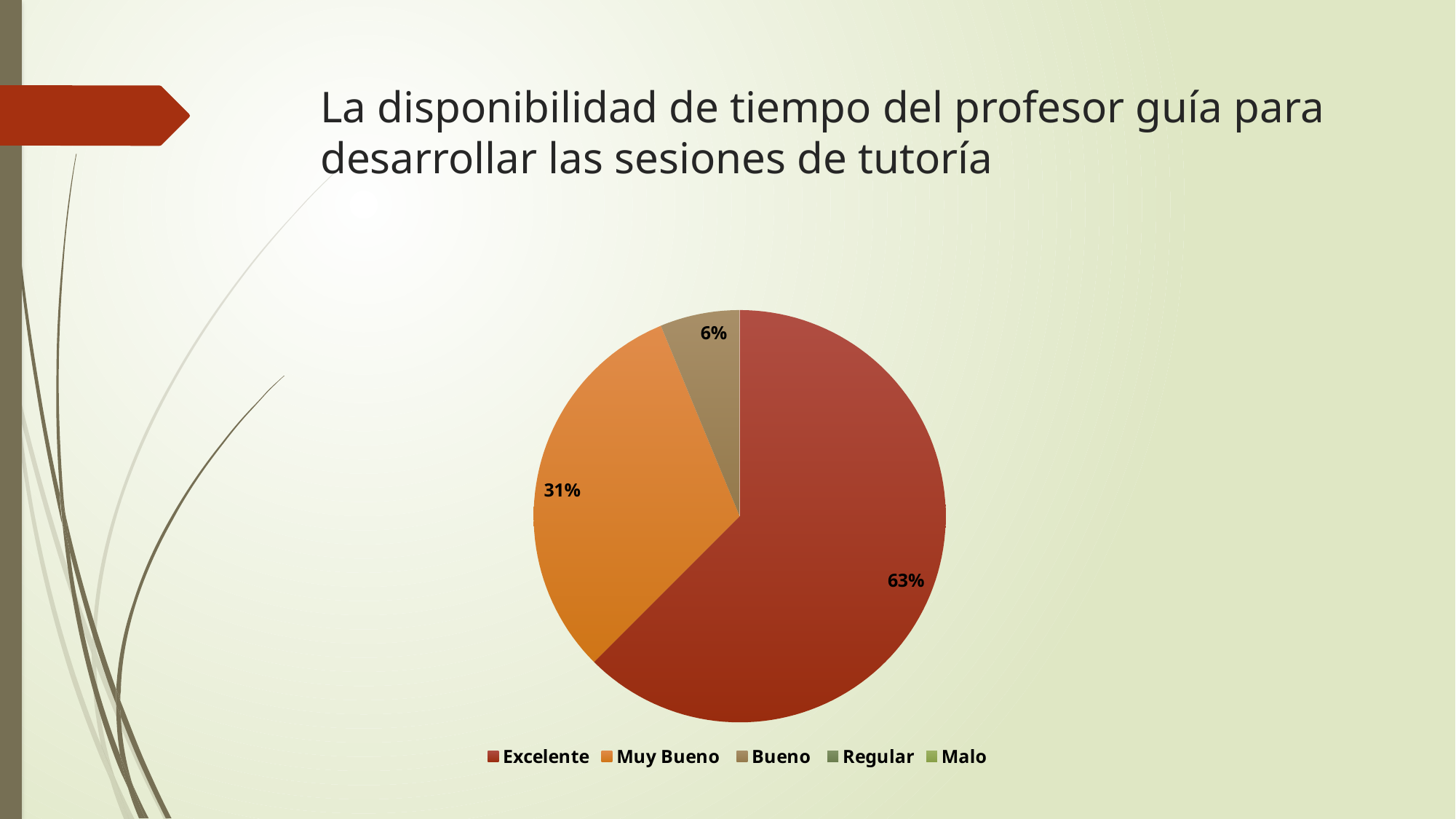
What is the difference between the Muy Bueno and Bueno shares? 25% What share of the pie does Bueno have? 6% Which is larger, the Muy Bueno slice or the Bueno slice? Muy Bueno How many categories does the legend list? 5 Which category has the largest slice of the pie? Excelente Which of the labelled slices is the smallest? Bueno What is the difference between the Excelente and Muy Bueno shares? 32% What share of the pie does Excelente have? 63% What kind of chart is shown on the slide? pie chart What share of the pie does Muy Bueno have? 31% What is the title of the slide containing the chart? La disponibilidad de tiempo del profesor guía para desarrollar las sesiones de tutoría Which legend entry is shown in orange? Muy Bueno